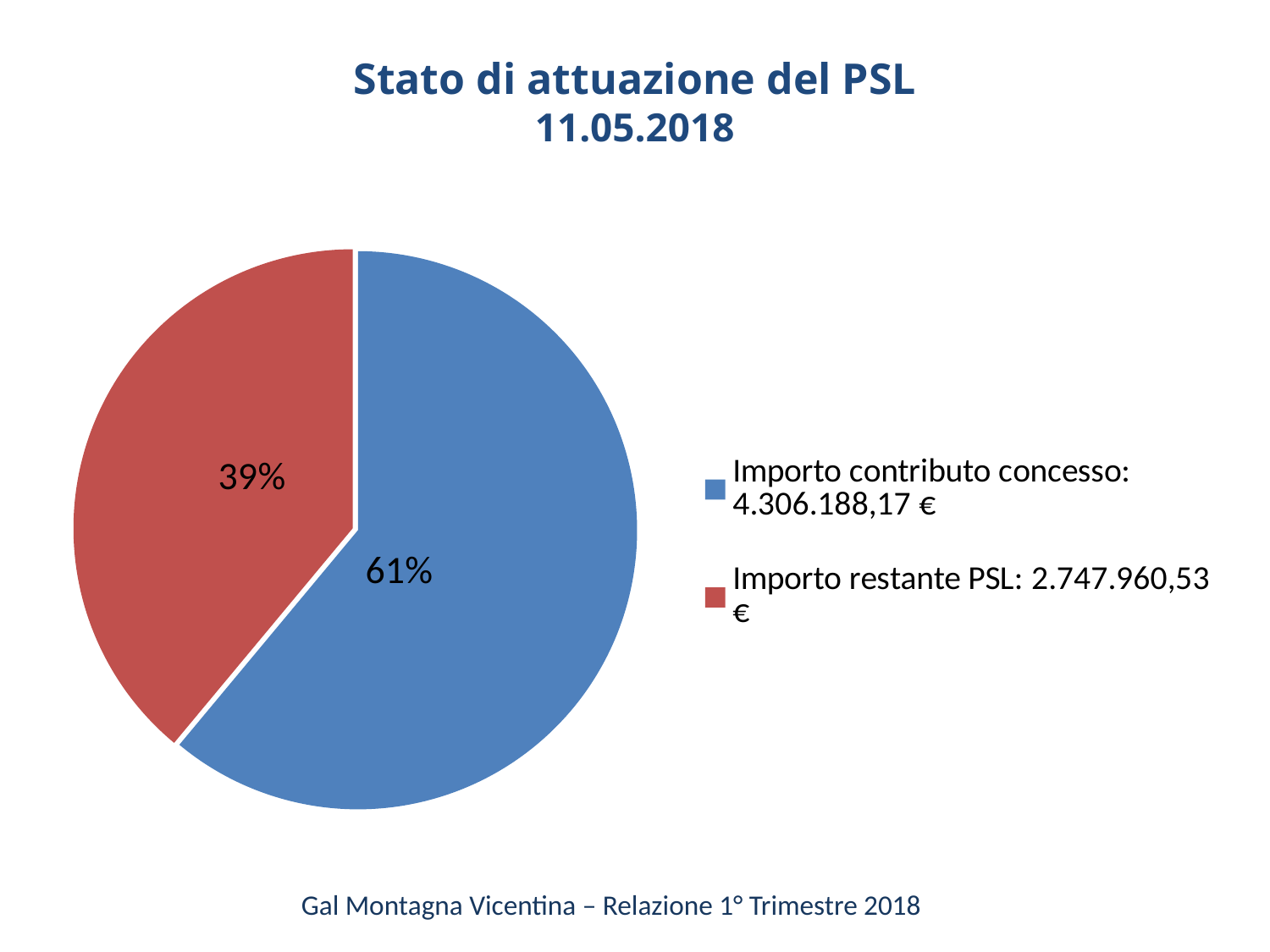
What share of the pie does "Importo restante PSL" represent? 39% What amount is given in the legend for "Importo contributo concesso"? 4.306.188,17 € What share of the pie does "Importo contributo concesso" represent? 61% Which is larger: the share for "Importo contributo concesso" or the share for "Importo restante PSL"? Importo contributo concesso How many slices does the pie chart have? 2 Which slice is the smallest in the pie chart? Importo restante PSL What is the difference in percentage points between the "Importo contributo concesso" slice and the "Importo restante PSL" slice? 22 percentage points What amount is given in the legend for "Importo restante PSL"? 2.747.960,53 € Which slice is the largest in the pie chart? Importo contributo concesso What colour is the slice for "Importo restante PSL"? red How many entries does the legend list? 2 What kind of chart is shown on the slide? pie chart